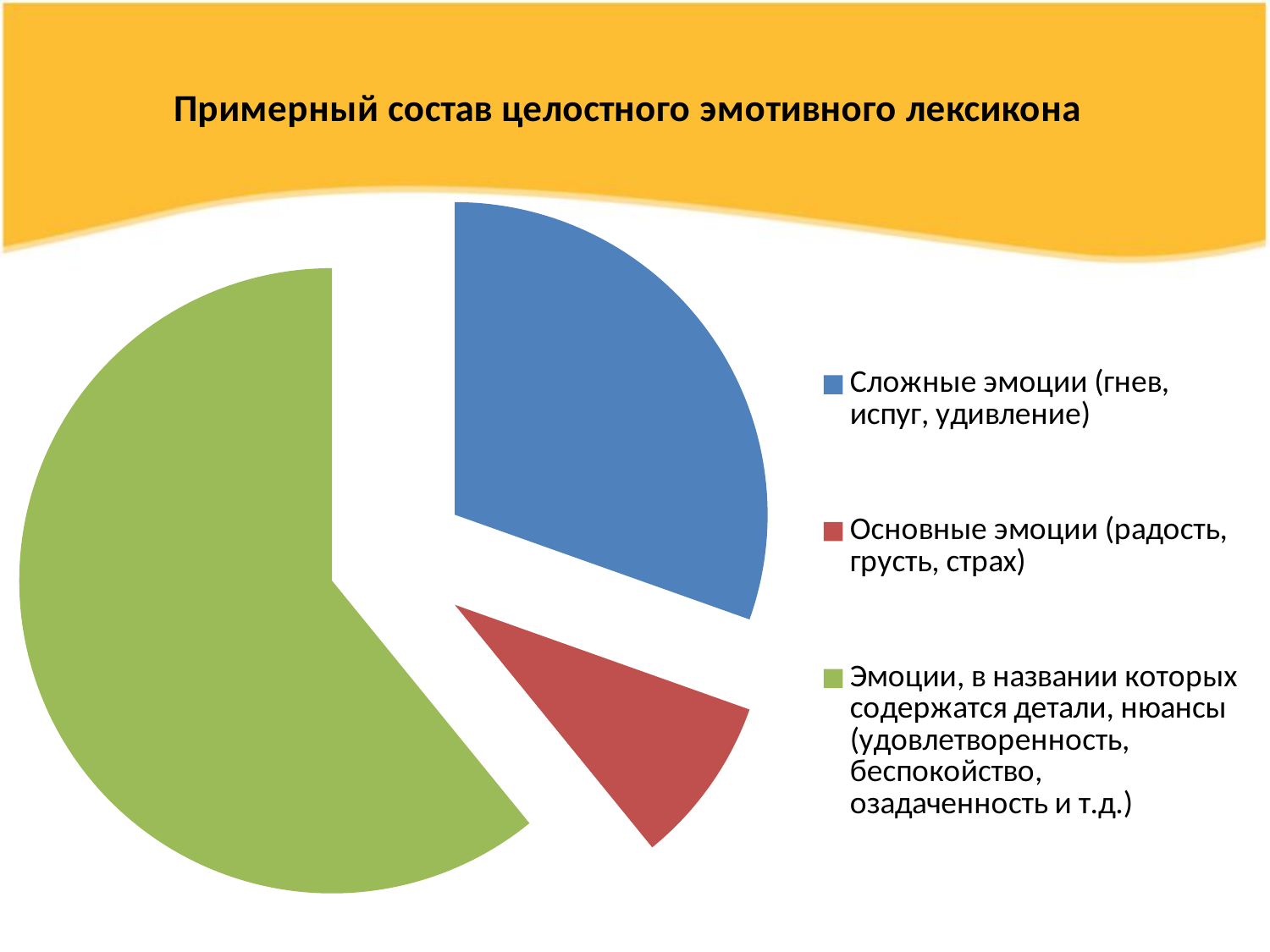
Which slice is larger: Сложные эмоции (гнев, испуг, удивление) or Эмоции, в названии которых содержатся детали, нюансы? Эмоции, в названии которых содержатся детали, нюансы What kind of chart is shown on the slide? Pie chart Which category has the largest slice of the pie chart? Эмоции, в названии которых содержатся детали, нюансы (удовлетворенность, беспокойство, озадаченность и т.д.) Which category has the smallest slice of the pie chart? Основные эмоции (радость, грусть, страх) What colour is the slice for Основные эмоции (радость, грусть, страх)? Red What is the title of the slide with the pie chart? Примерный состав целостного эмотивного лексикона How many entries does the legend of the pie chart list? 3 How many slices does the pie chart have? 3 Which slice is larger: Сложные эмоции (гнев, испуг, удивление) or Основные эмоции (радость, грусть, страх)? Сложные эмоции (гнев, испуг, удивление)